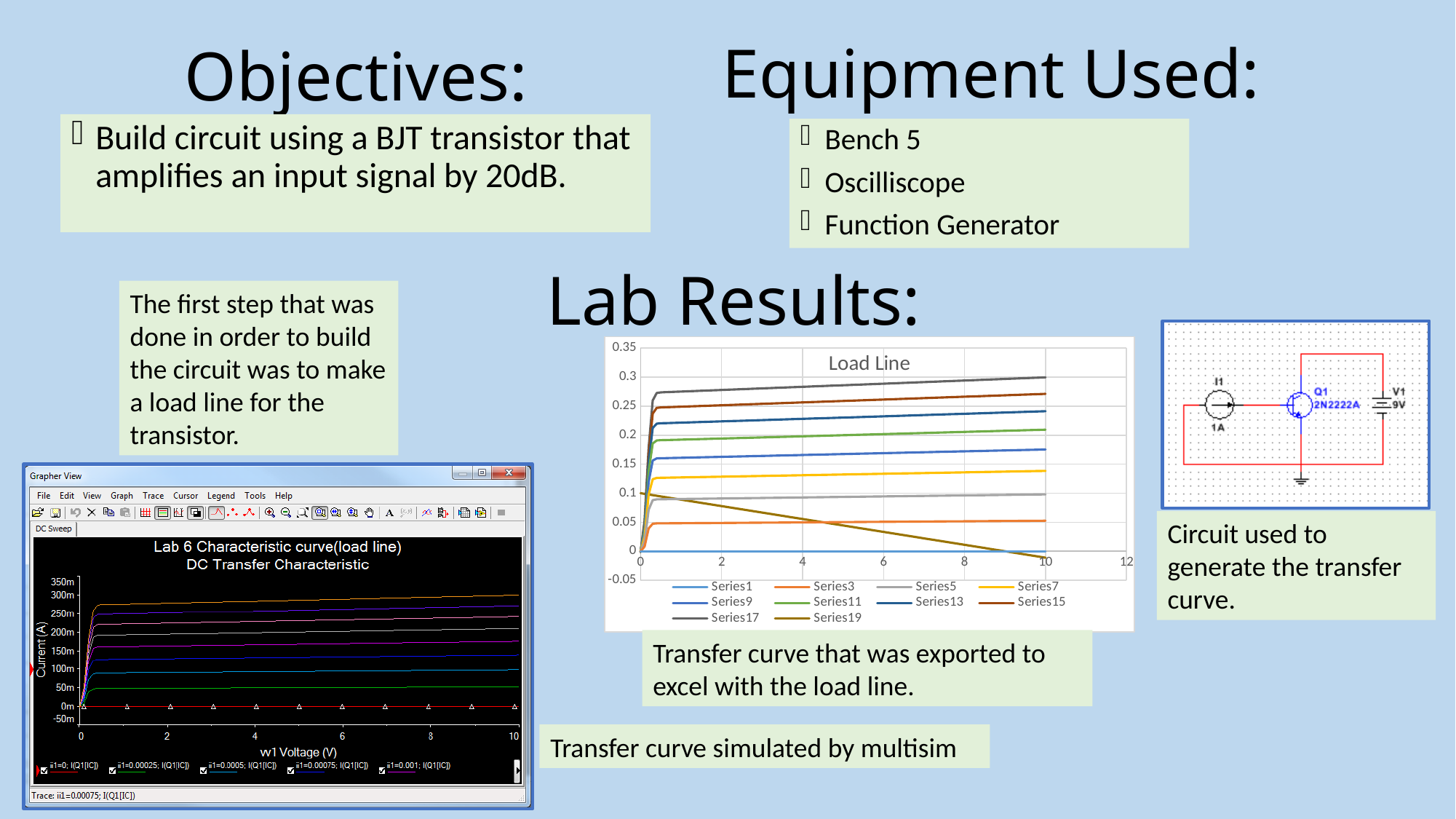
What is the x-axis label of the Multisim "DC Transfer Characteristic" chart? vv1 Voltage (V) How many series does the legend of the "Load Line" chart list? 10 In the "Load Line" chart, which series has the highest value at x = 10? Series17 What is the title of the Excel chart in the Lab Results section? Load Line In the "Load Line" chart, which is larger at x = 10, Series17 or Series1? Series17 In the "Load Line" chart, does Series19 rise or fall as x increases? fall What kind of chart is the Multisim "DC Transfer Characteristic" chart? line chart In the "Load Line" chart, is the value of Series19 at x = 6 greater or less than 0.1? less In the Multisim "DC Transfer Characteristic" chart, is the topmost trace at 10 V greater or less than 250m? greater In the "Load Line" chart, is the value of Series17 at x = 10 greater or less than 0.25? greater What kind of chart is the "Load Line" chart? line chart